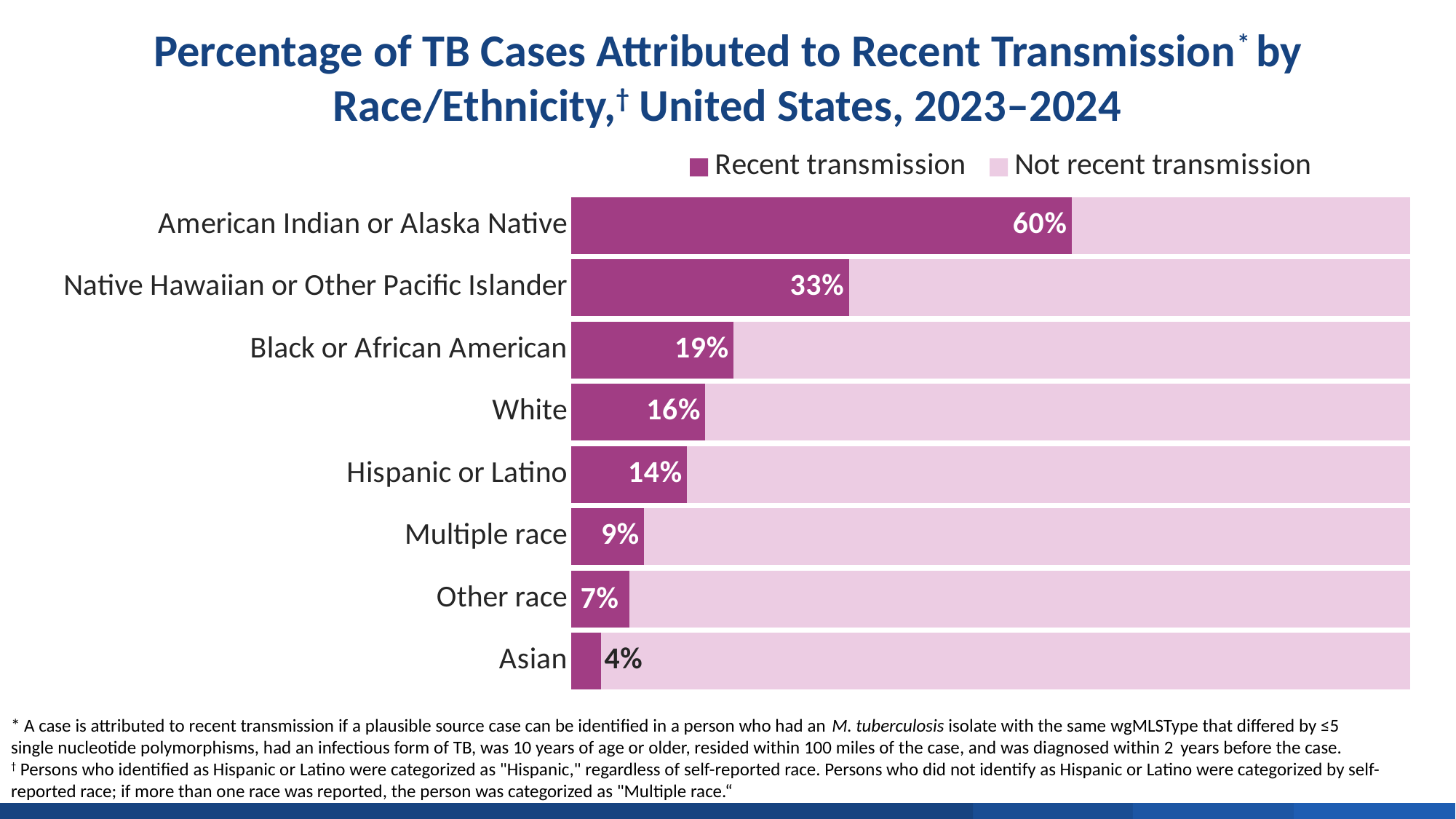
What type of chart is shown on the slide? Stacked bar chart What are the two legend entries in the chart? Recent transmission; Not recent transmission Which race/ethnicity group has the lowest percentage of TB cases attributed to recent transmission? Asian Which has a higher recent transmission percentage, Multiple race or Other race? Multiple race Which race/ethnicity group has the highest percentage of TB cases attributed to recent transmission? American Indian or Alaska Native What is the difference in recent transmission percentage between American Indian or Alaska Native and Native Hawaiian or Other Pacific Islander? 27% How many race/ethnicity categories are shown in the chart? 8 What is the recent transmission percentage for Hispanic or Latino? 14% What is the recent transmission percentage for Native Hawaiian or Other Pacific Islander? 33% How many series does the legend list? 2 What is the difference in recent transmission percentage between Black or African American and White? 3% What percentage of TB cases among American Indian or Alaska Native persons is attributed to recent transmission? 60%